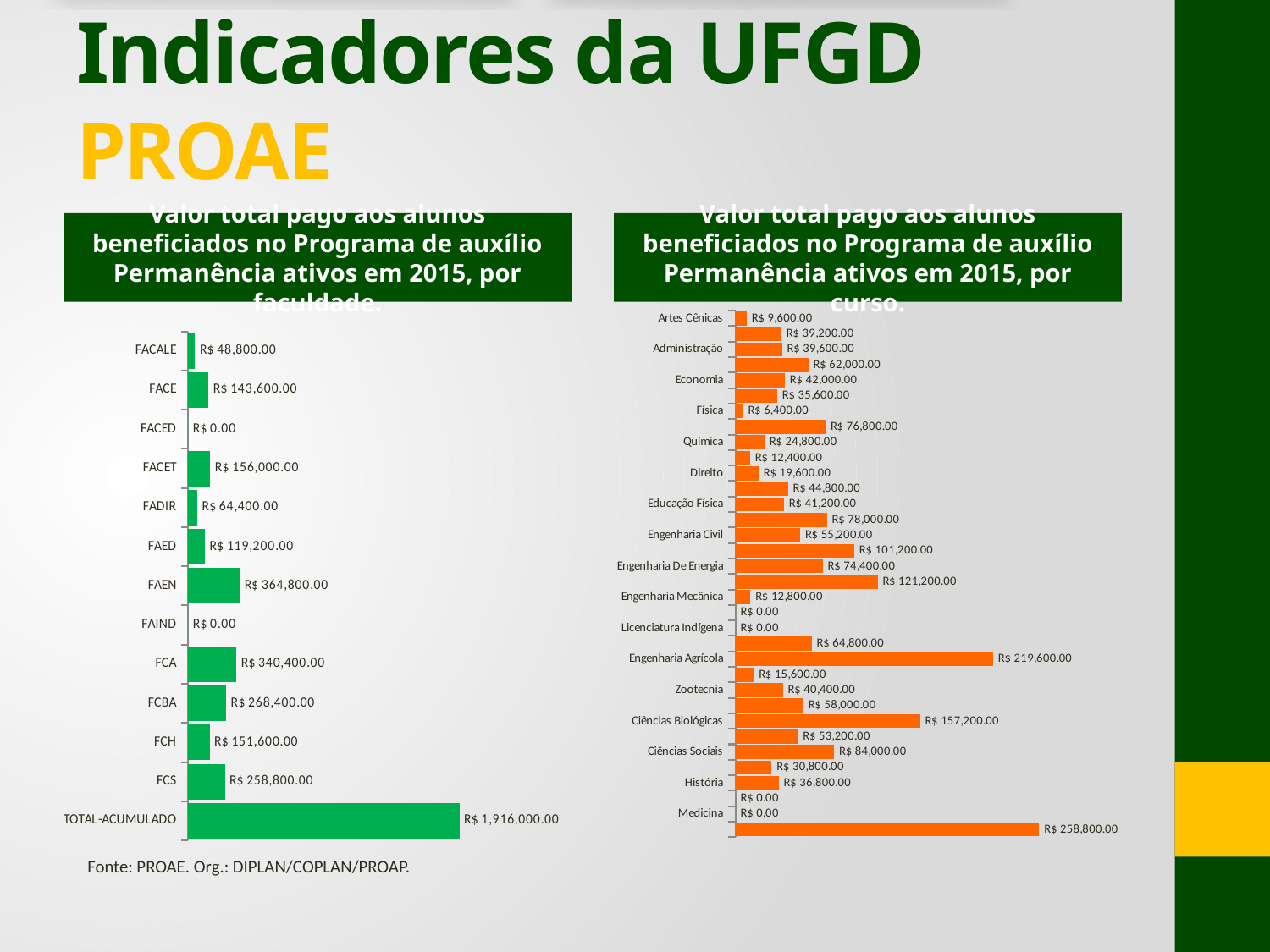
In the left chart (por faculdade), which is larger, the value for FCBA or the value for FCS? FCBA What kind of chart is the left chart (por faculdade)? Bar chart In the right chart (por curso), what is the value for Engenharia Agrícola? R$ 219,600.00 What colour are the bars in the right chart (por curso)? Orange In the left chart (por faculdade), what is the value for FAEN? R$ 364,800.00 In the left chart (por faculdade), excluding TOTAL-ACUMULADO, which faculty has the highest value? FAEN In the left chart (por faculdade), how many categories are plotted, including TOTAL-ACUMULADO? 13 In the left chart (por faculdade), what is the value for TOTAL-ACUMULADO? R$ 1,916,000.00 In the left chart (por faculdade), what is the difference between the values for FAEN and FCA? R$ 24,400.00 In the left chart (por faculdade), how many faculties show a value of R$ 0.00? 2 In the right chart (por curso), what is the value for Artes Cênicas? R$ 9,600.00 In the right chart (por curso), which is larger, the value for Engenharia Agrícola or the value for Ciências Biológicas? Engenharia Agrícola